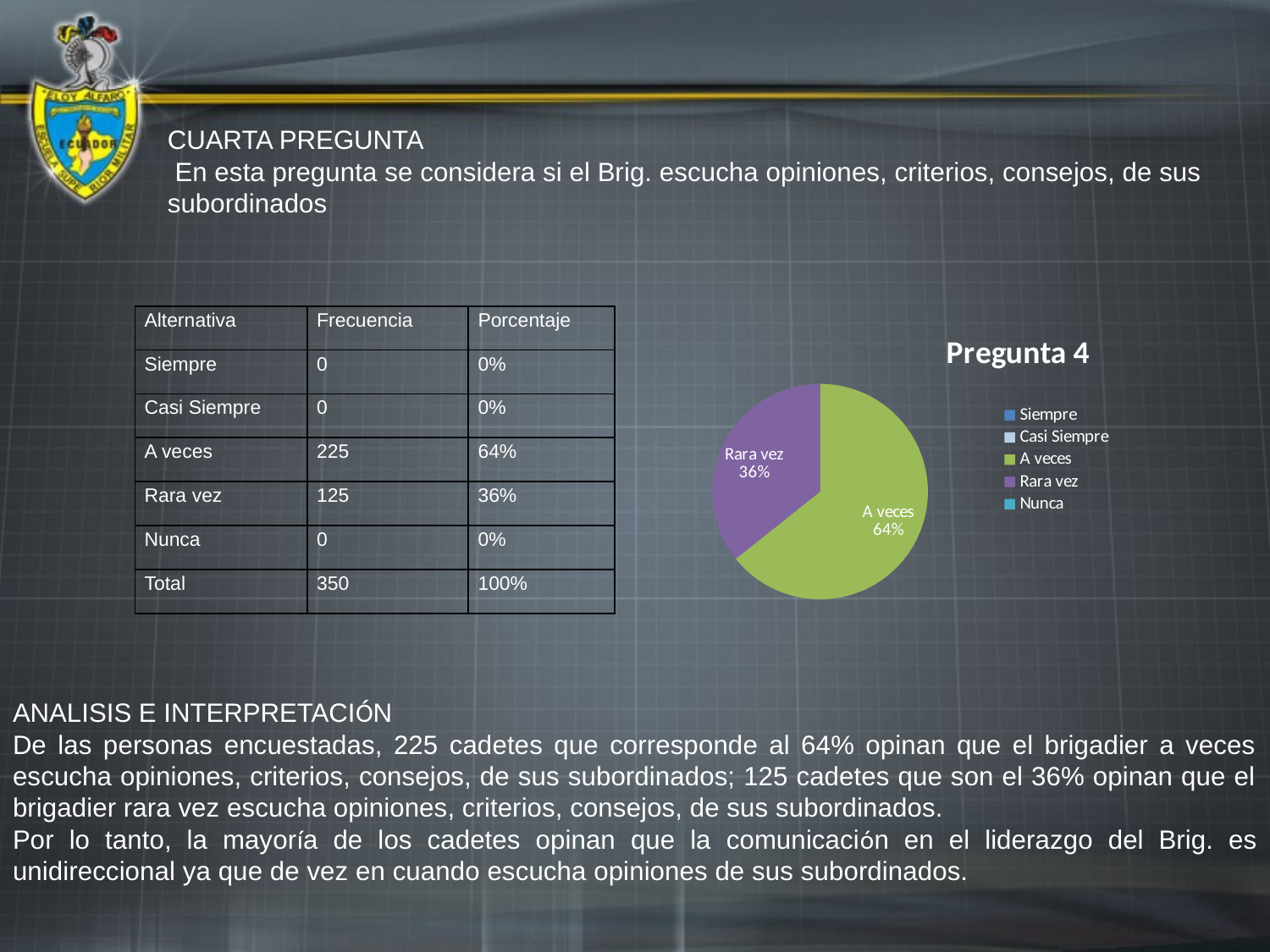
What is the difference in percentage points between the 'A veces' and 'Rara vez' slices? 28% What kind of chart is shown on the slide? pie chart How many entries does the legend list? 5 What is the chart's title? Pregunta 4 What percentage does the 'A veces' slice show? 64% What percentage does the 'Rara vez' slice show? 36% Is the 'Rara vez' share of the pie greater or less than 50%? less What colour is the 'A veces' slice? green How many slices are visible in the pie? 2 Which is larger, the 'A veces' slice or the 'Rara vez' slice? A veces Which category has the largest slice of the pie? A veces